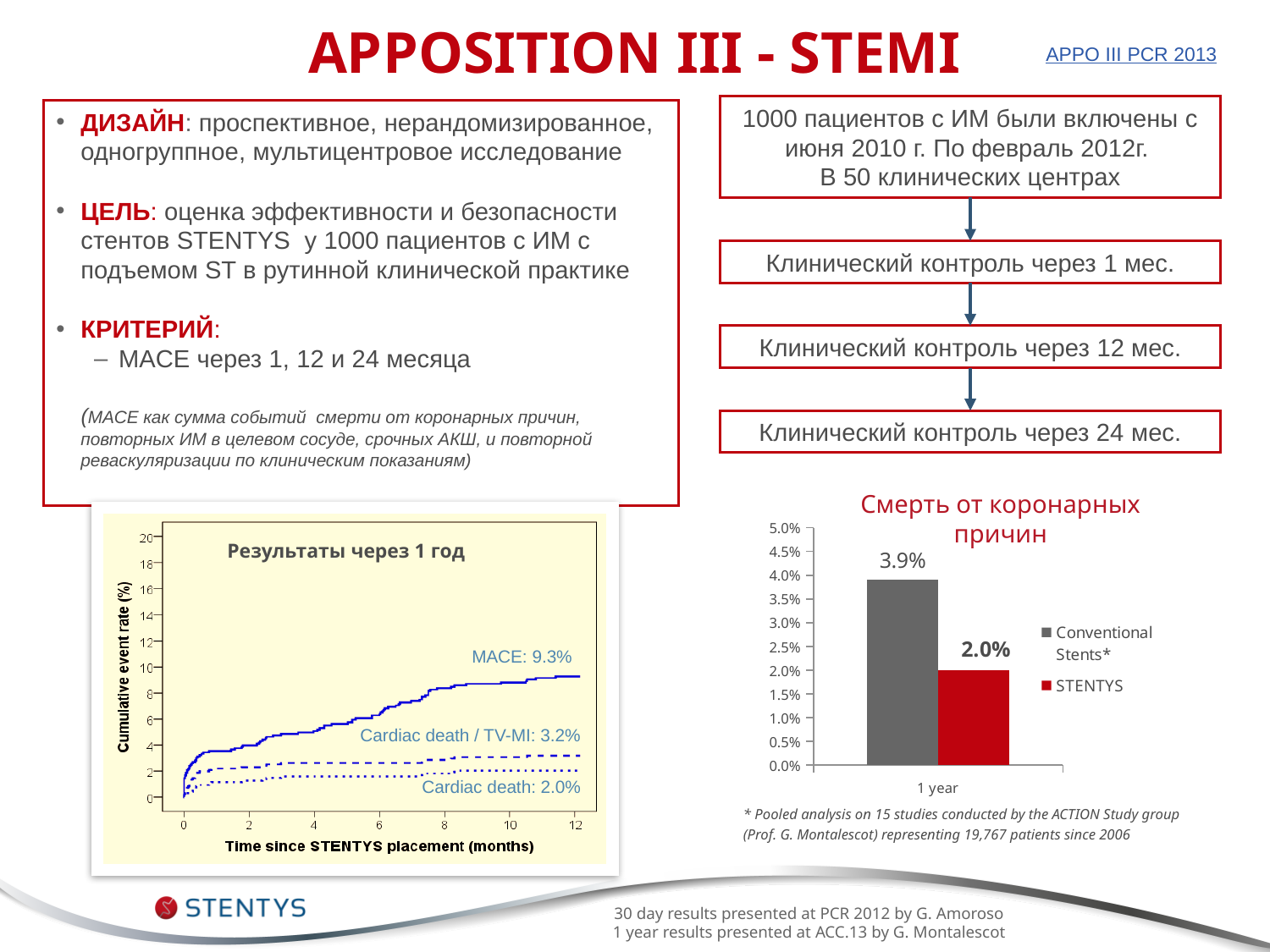
On the line chart titled "Результаты через 1 год", what is the MACE rate at 12 months? 9.3% On the bar chart titled "Смерть от коронарных причин", which series has the higher value? Conventional Stents* On the bar chart titled "Смерть от коронарных причин", is the value for STENTYS greater or less than 2.5%? less On the bar chart titled "Смерть от коронарных причин", what is the label on the x axis category? 1 year On the bar chart titled "Смерть от коронарных причин", what is the value for STENTYS? 2.0% On the line chart titled "Результаты через 1 год", do the curves rise or fall over time since STENTYS placement? rise On the line chart titled "Результаты через 1 год", what is the Cardiac death / TV-MI rate? 3.2% On the bar chart titled "Смерть от коронарных причин", what is the value for Conventional Stents*? 3.9% On the bar chart titled "Смерть от коронарных причин", what is the difference between the Conventional Stents* value and the STENTYS value? 1.9% On the bar chart titled "Смерть от коронарных причин", how many series does the legend list? 2 On the bar chart titled "Смерть от коронарных причин", what kind of chart is it? bar chart On the line chart titled "Результаты через 1 год", how many curves are plotted? 3